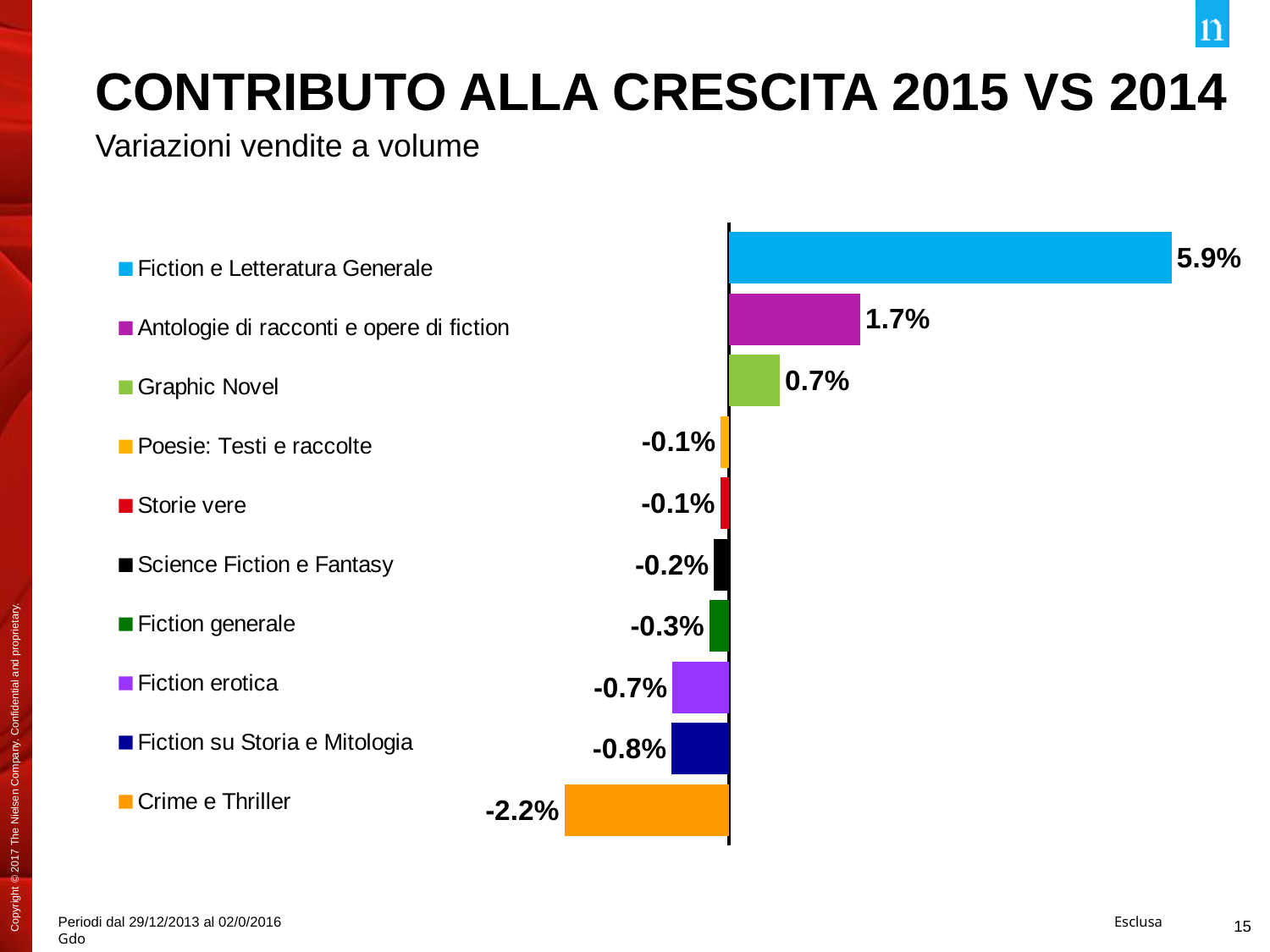
Which category has the highest value? Fiction e Letteratura Generale What is the value for Fiction e Letteratura Generale? 5.9% Which is larger, the value for Fiction erotica or the value for Fiction generale? Fiction generale How many entries does the legend list? 10 How many categories are shown in the chart? 10 What is the difference between the values for Fiction e Letteratura Generale and Antologie di racconti e opere di fiction? 4.2% What is the value for Crime e Thriller? -2.2% What kind of chart is shown on the slide? Bar chart Which category has the lowest value? Crime e Thriller What is the subtitle shown under the slide title? Variazioni vendite a volume What is the value for Fiction su Storia e Mitologia? -0.8% What is the value for Graphic Novel? 0.7%